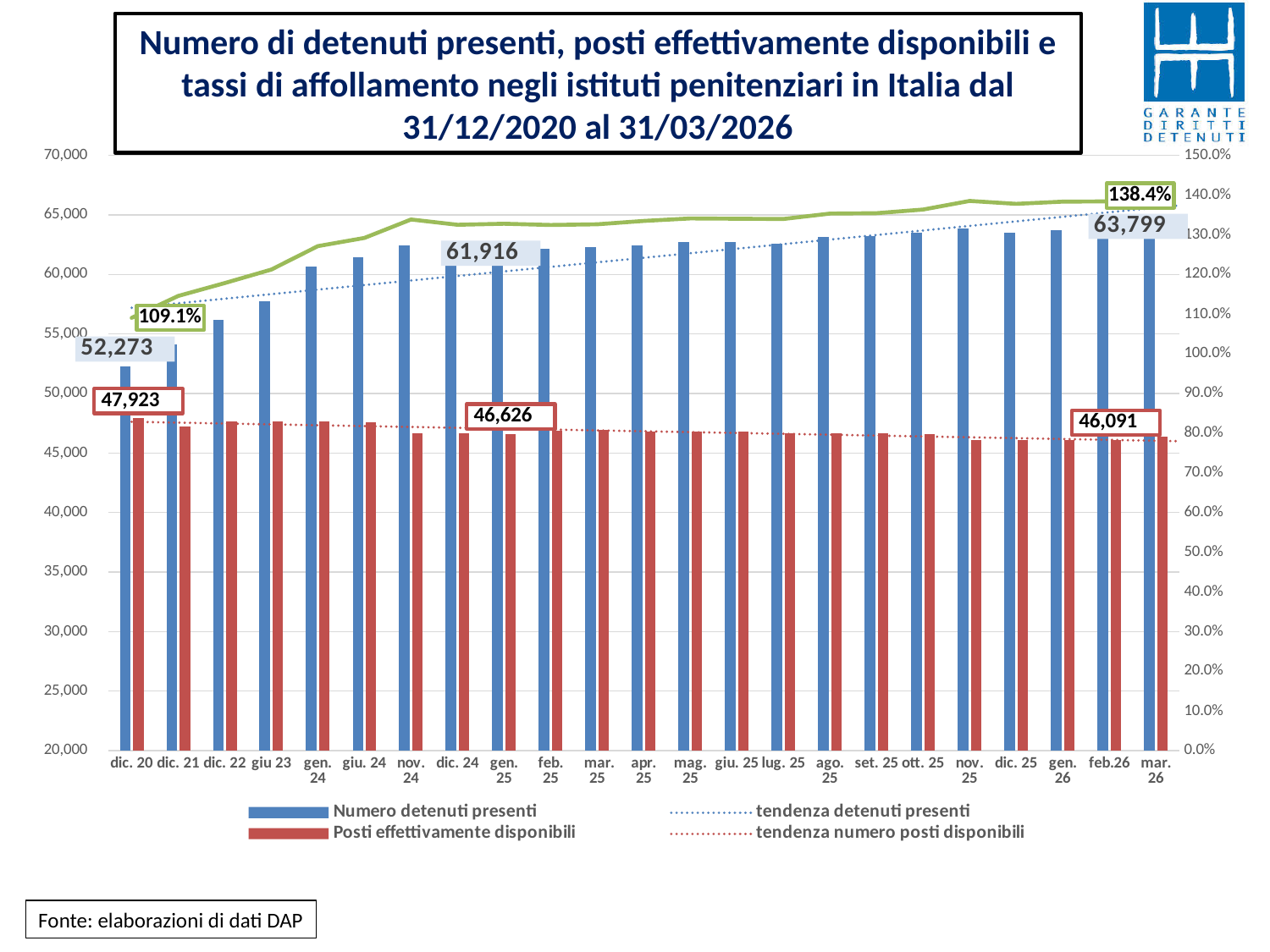
What overcrowding rate (percentage) is labelled on the green line for dic. 20? 109.1% What is the number of 'Numero detenuti presenti' for dic. 20? 52,273 Is the 'Numero detenuti presenti' value for dic. 22 greater or less than 55,000? greater How many time periods are shown on the x axis? 23 Which period has the lowest 'Numero detenuti presenti'? dic. 20 What is the value of 'Posti effettivamente disponibili' for dic. 20? 47,923 How many series does the legend list? 4